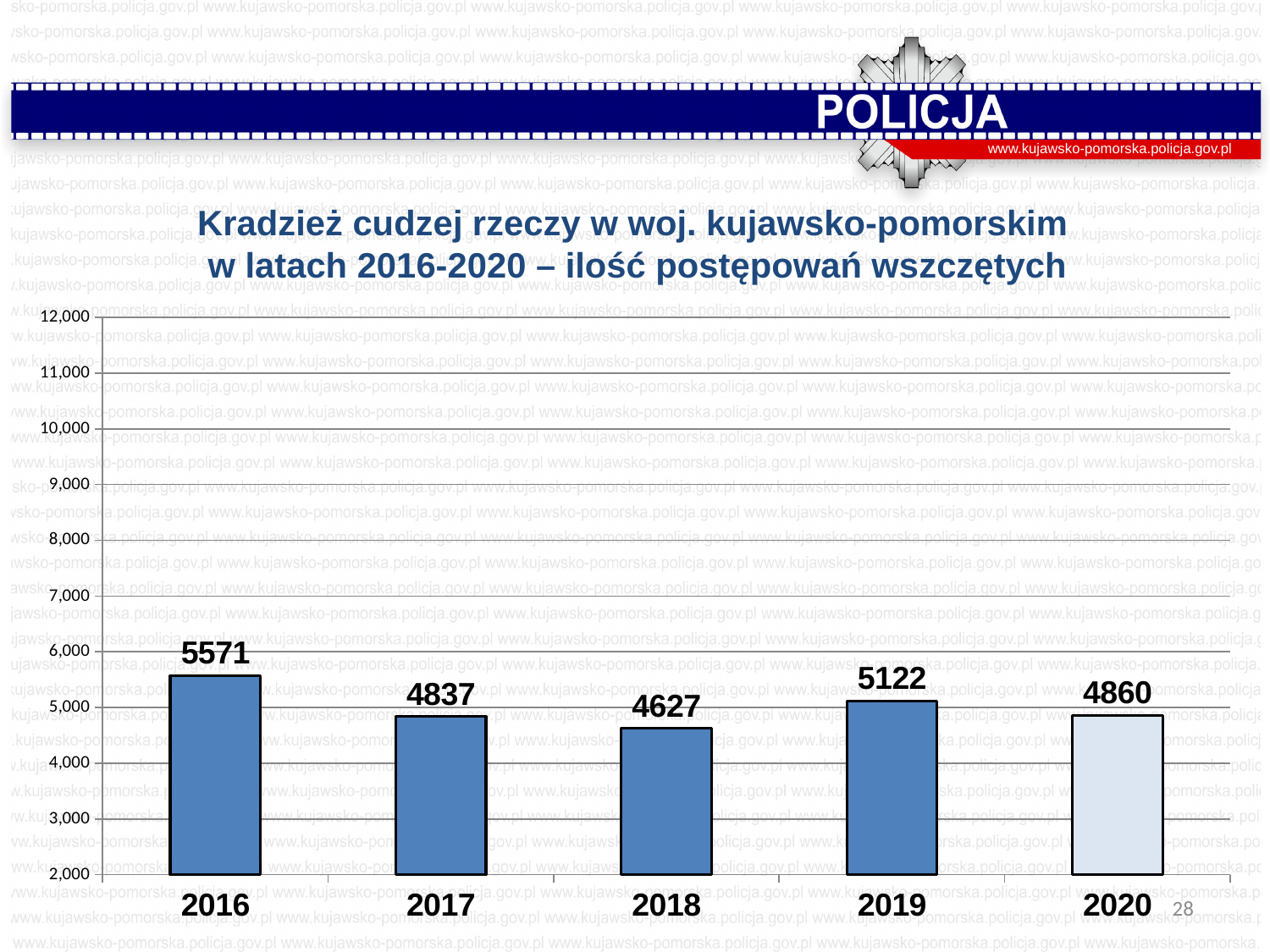
What is the difference between the values for 2019 and 2018? 495 What kind of chart is shown on the slide? bar chart How many years are shown on the chart? 5 Is the value for 2017 greater or less than 5,000? less What is the value for 2020? 4860 Which is larger, the value for 2019 or the value for 2020? 2019 Which year has the lowest value? 2018 What is the value for 2018? 4627 What is the value for 2016? 5571 Which year has the highest value? 2016 Do the values rise or fall from 2016 to 2018? fall What is the difference between the values for 2016 and 2017? 734